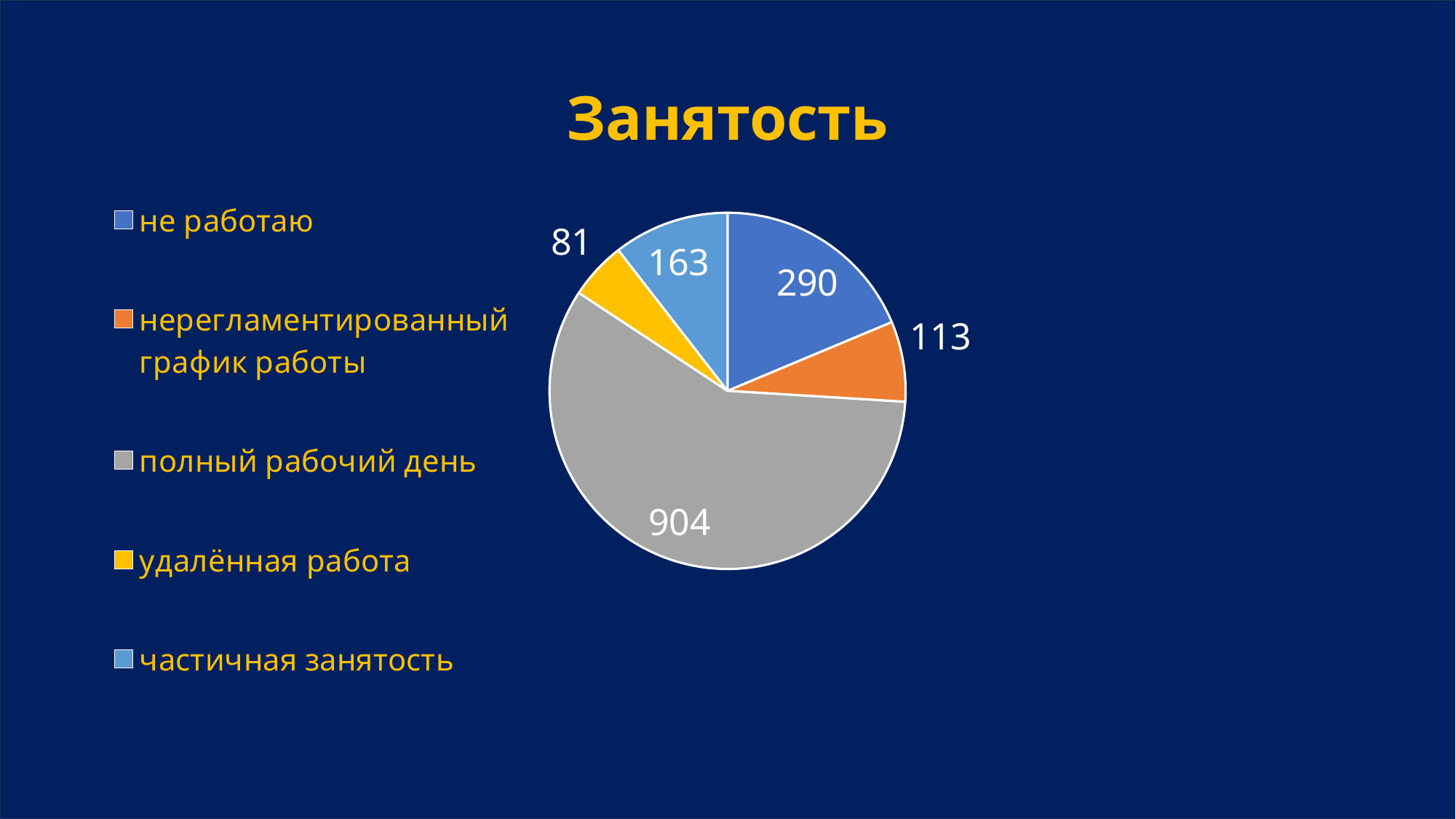
Which category has the largest slice? полный рабочий день What kind of chart is shown on the slide? pie chart What is the value for "не работаю"? 290 Which category has the smallest slice? удалённая работа What colour is the slice for "удалённая работа"? yellow What is the value for "частичная занятость"? 163 What is the value for "удалённая работа"? 81 What is the difference between the values for "не работаю" and "нерегламентированный график работы"? 177 Which is larger, the value for "частичная занятость" or the value for "нерегламентированный график работы"? частичная занятость How many categories does the pie chart have? 5 What is the value for "полный рабочий день"? 904 What is the title of the chart? Занятость